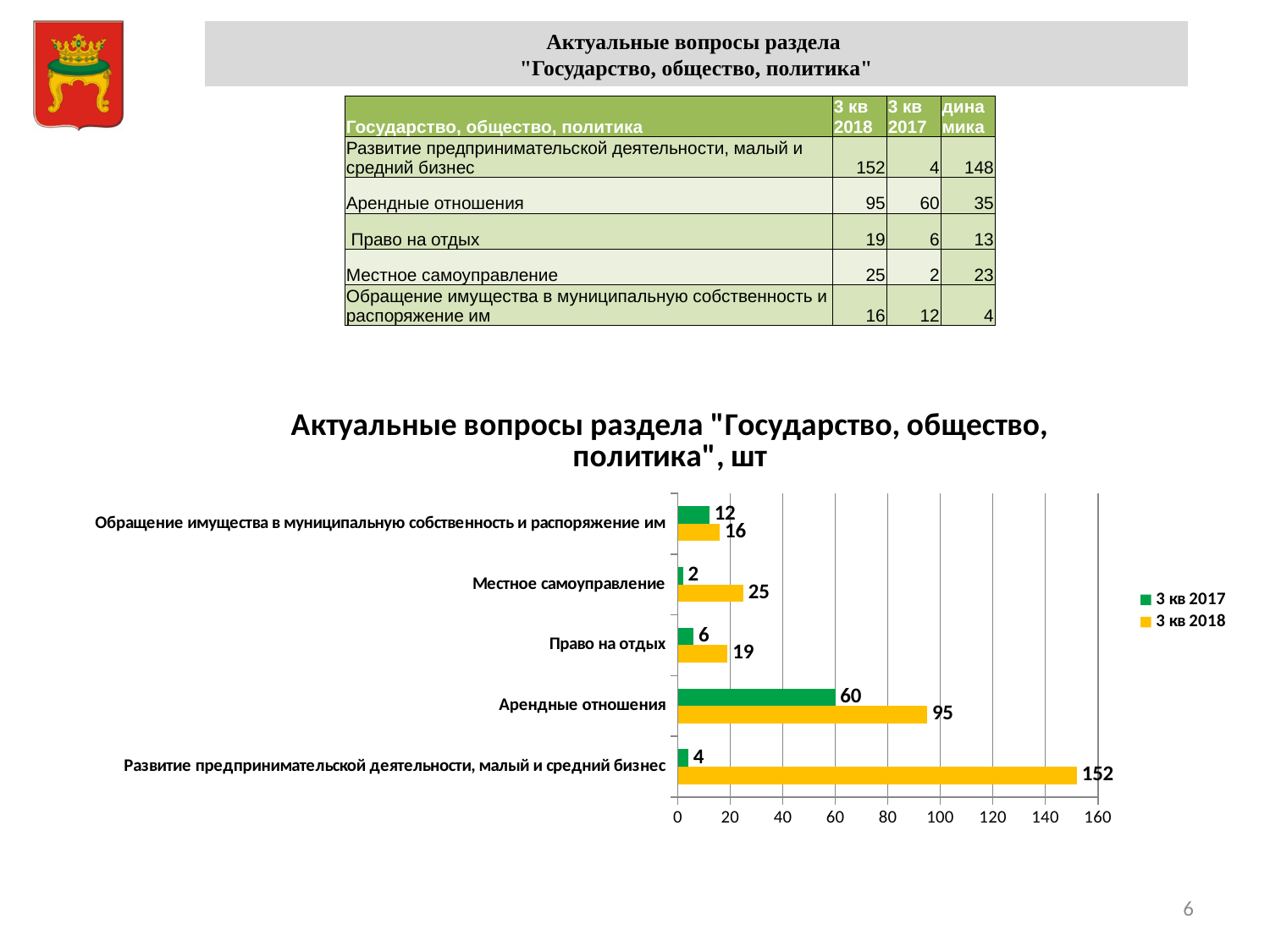
Which is larger for "Обращение имущества в муниципальную собственность и распоряжение им": the "3 кв 2017" value or the "3 кв 2018" value? 3 кв 2018 Which colour represents the "3 кв 2017" series in the chart? Green What is the value for "Арендные отношения" in the "3 кв 2018" series? 95 Which category has the lowest value in the "3 кв 2017" series? Местное самоуправление How many categories are shown on the chart? 5 Which category has the highest value in the "3 кв 2018" series? Развитие предпринимательской деятельности, малый и средний бизнес What is the value for "Местное самоуправление" in the "3 кв 2018" series? 25 What is the difference between the "3 кв 2018" and "3 кв 2017" values for "Арендные отношения"? 35 What is the value for "Право на отдых" in the "3 кв 2017" series? 6 How many series does the legend list? 2 What kind of chart is shown on the slide? Bar chart What is the difference between the "3 кв 2018" and "3 кв 2017" values for "Развитие предпринимательской деятельности, малый и средний бизнес"? 148